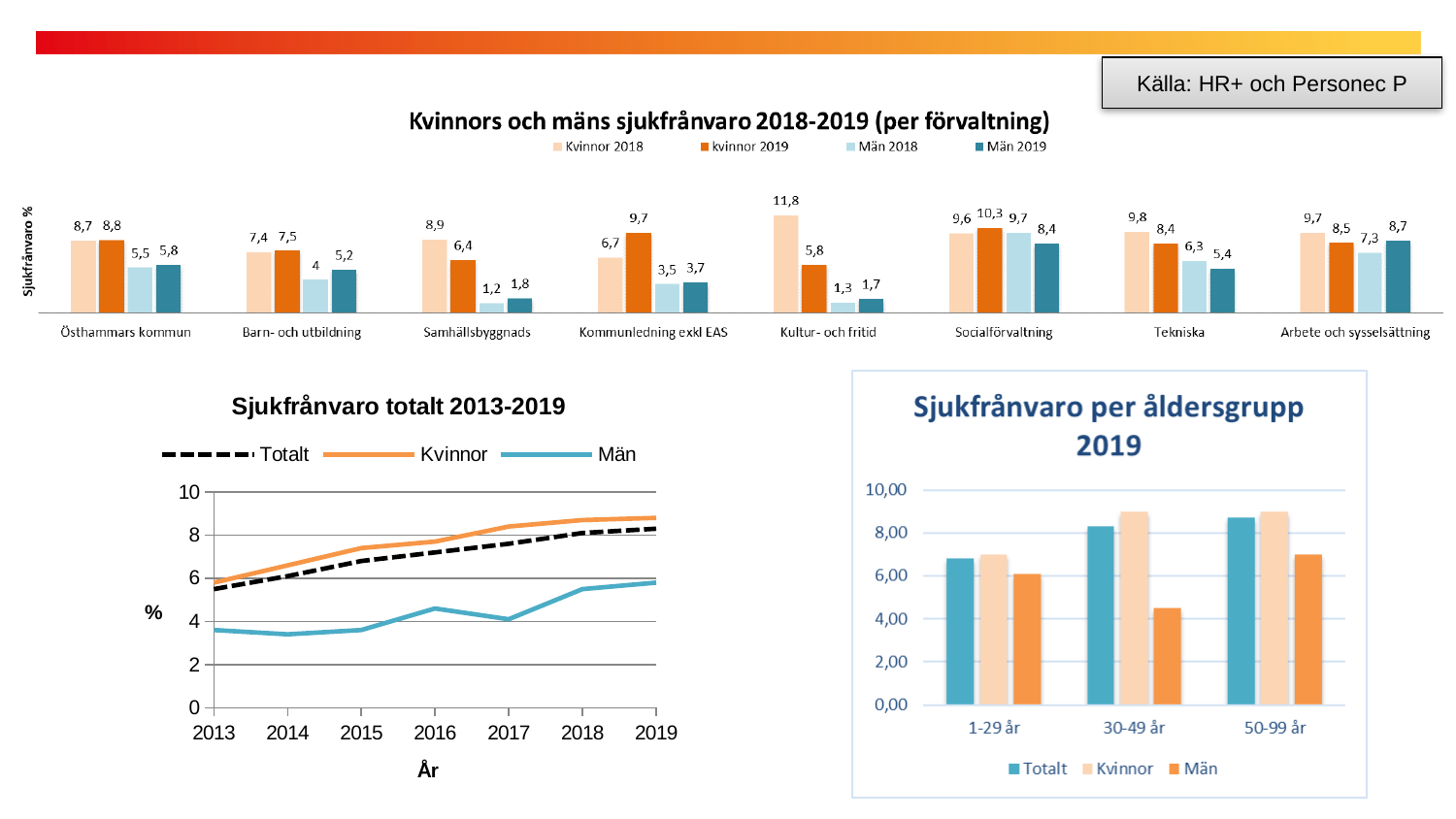
What kind of chart is 'Sjukfrånvaro totalt 2013-2019'? Line chart In the chart 'Kvinnors och mäns sjukfrånvaro 2018-2019 (per förvaltning)', which is larger for Tekniska: Kvinnor 2018 or kvinnor 2019? Kvinnor 2018 In the chart 'Sjukfrånvaro totalt 2013-2019', does the Totalt line rise or fall from 2013 to 2019? Rise In the chart 'Sjukfrånvaro per åldersgrupp 2019', is the value for Män in the 30-49 år group greater or less than 6,00? less In the chart 'Kvinnors och mäns sjukfrånvaro 2018-2019 (per förvaltning)', what is the value for Kvinnor 2018 in Kultur- och fritid? 11,8 In the chart 'Kvinnors och mäns sjukfrånvaro 2018-2019 (per förvaltning)', which förvaltning has the lowest value for Män 2018? Samhällsbyggnads In the chart 'Sjukfrånvaro totalt 2013-2019', is the value for Män in 2013 greater or less than 4? less In the chart 'Kvinnors och mäns sjukfrånvaro 2018-2019 (per förvaltning)', what is the difference between the kvinnor 2019 and Kvinnor 2018 values for Kommunledning exkl EAS? 3 How many series does the legend of the chart 'Kvinnors och mäns sjukfrånvaro 2018-2019 (per förvaltning)' list? 4 How many förvaltningar (categories) are shown in the chart 'Kvinnors och mäns sjukfrånvaro 2018-2019 (per förvaltning)'? 8 In the chart 'Sjukfrånvaro per åldersgrupp 2019', which age group has the lowest Totalt value? 1-29 år In the chart 'Kvinnors och mäns sjukfrånvaro 2018-2019 (per förvaltning)', what is the value for Män 2019 in Socialförvaltning? 8,4